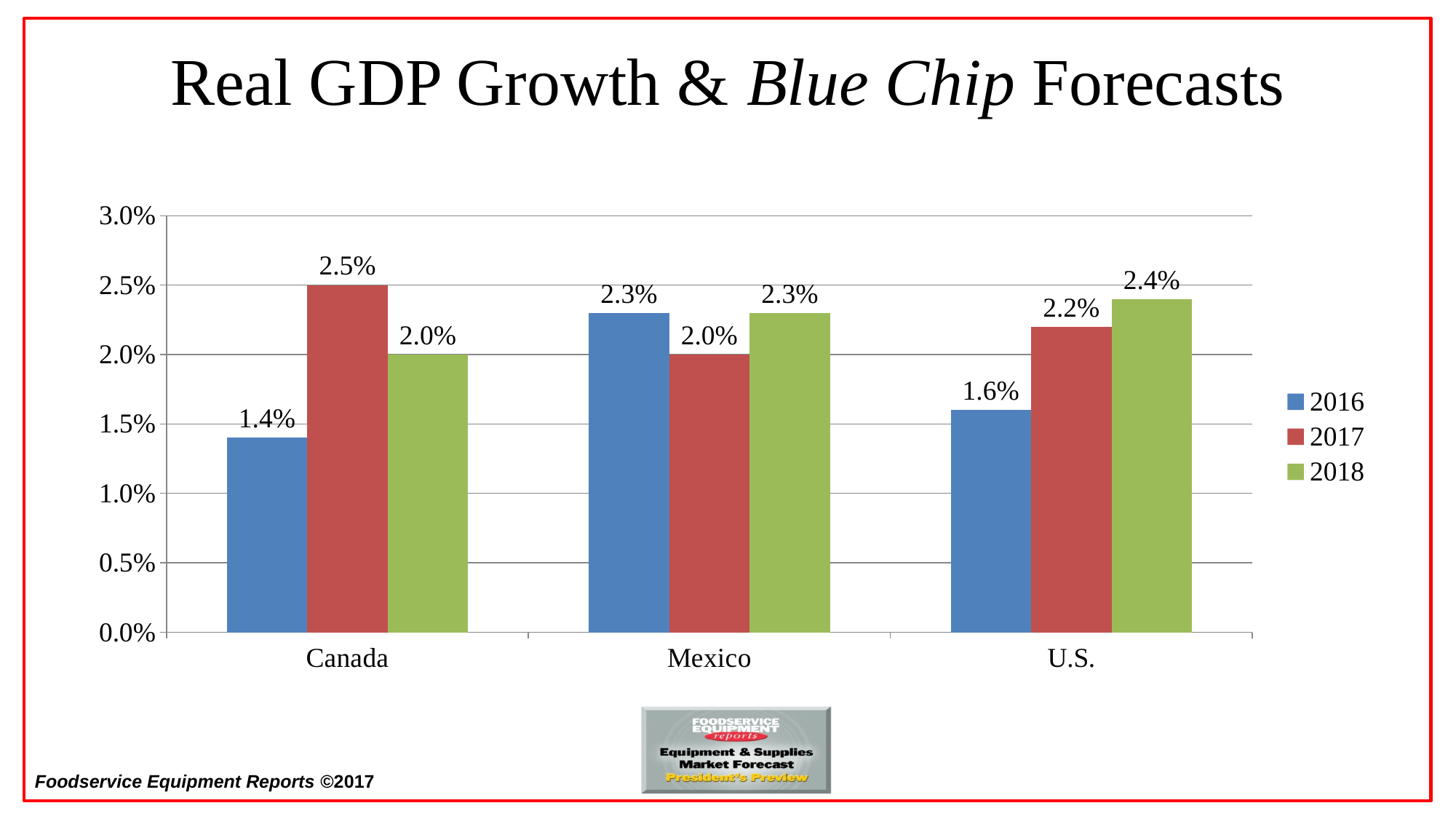
Do the values for the U.S. rise or fall from 2016 to 2018? rise Which is larger for the U.S., the 2016 value or the 2018 value? 2018 What is the difference between the 2017 and 2016 values for Canada? 1.1% How many series does the legend list? 3 Is the 2016 value for Mexico greater or less than 2.0%? greater What is the 2017 value for Mexico? 2.0% What is the 2018 value for the U.S.? 2.4% What is the 2016 value for Canada? 1.4% Which country has the highest 2017 value? Canada Which country has the lowest 2016 value? Canada How many countries are shown on the x axis? 3 What kind of chart is shown on the slide? bar chart